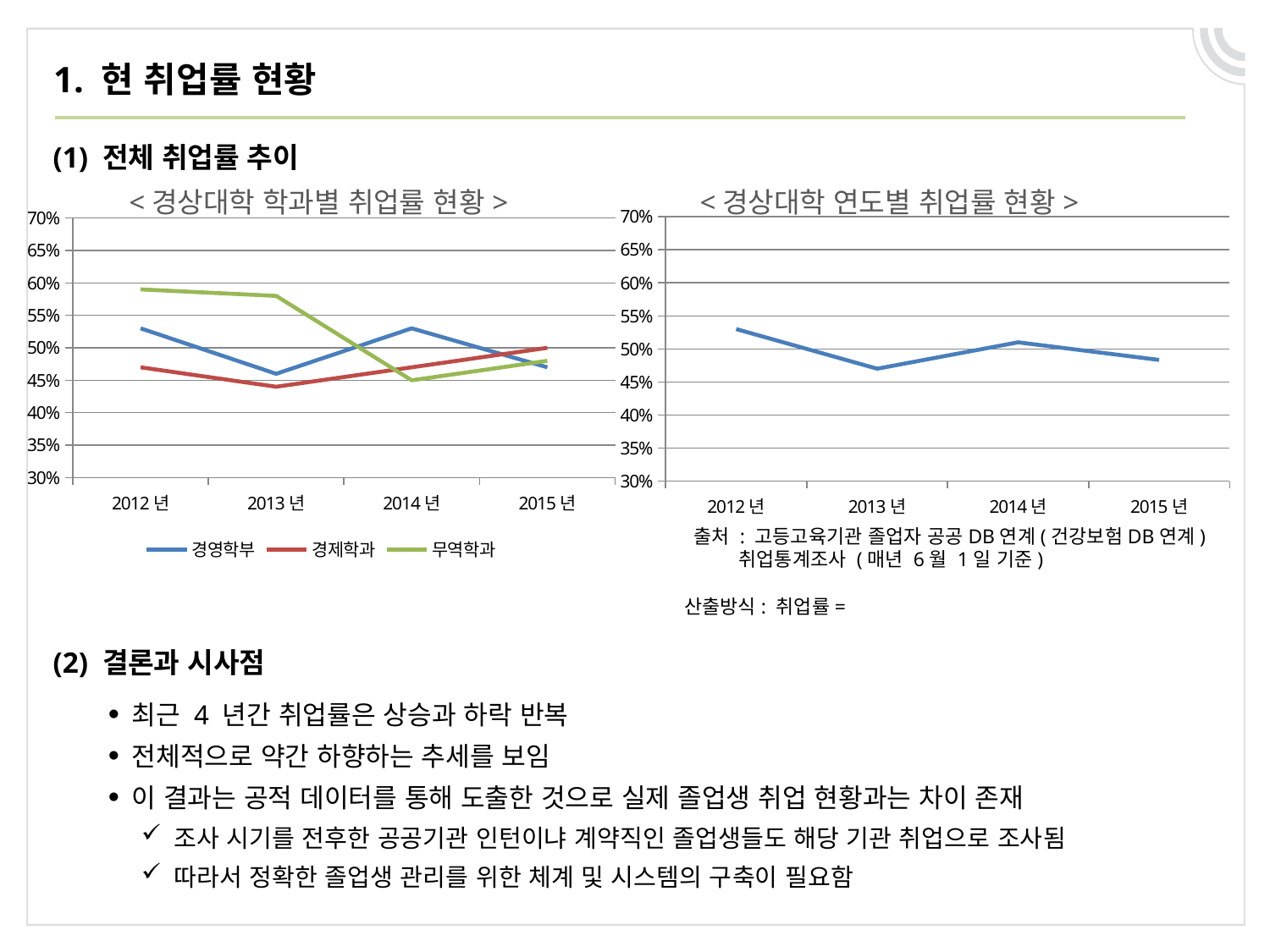
In the '경상대학 연도별 취업률 현황' chart, is the value for 2012년 greater or less than 50%? greater In the '경상대학 학과별 취업률 현황' chart, which series has the lowest value in 2013년? 경제학과 In the '경상대학 학과별 취업률 현황' chart, is the value for 무역학과 in 2012년 greater or less than 55%? greater In the '경상대학 학과별 취업률 현황' chart, which is larger in 2014년: 경영학부 or 무역학과? 경영학부 How many series does the legend of the '경상대학 학과별 취업률 현황' chart list? 3 In the '경상대학 학과별 취업률 현황' chart, which series has the highest value in 2012년? 무역학과 What colour is the 경영학부 line in the '경상대학 학과별 취업률 현황' chart? blue How many years are shown on the x axis of the '경상대학 연도별 취업률 현황' chart? 4 In the '경상대학 연도별 취업률 현황' chart, which year has the lowest value? 2013년 What kind of chart is the '경상대학 학과별 취업률 현황' chart? line chart In the '경상대학 학과별 취업률 현황' chart, does the 무역학과 line rise or fall from 2012년 to 2014년? fall In the '경상대학 학과별 취업률 현황' chart, is the value for 경제학과 in 2013년 greater or less than 45%? less